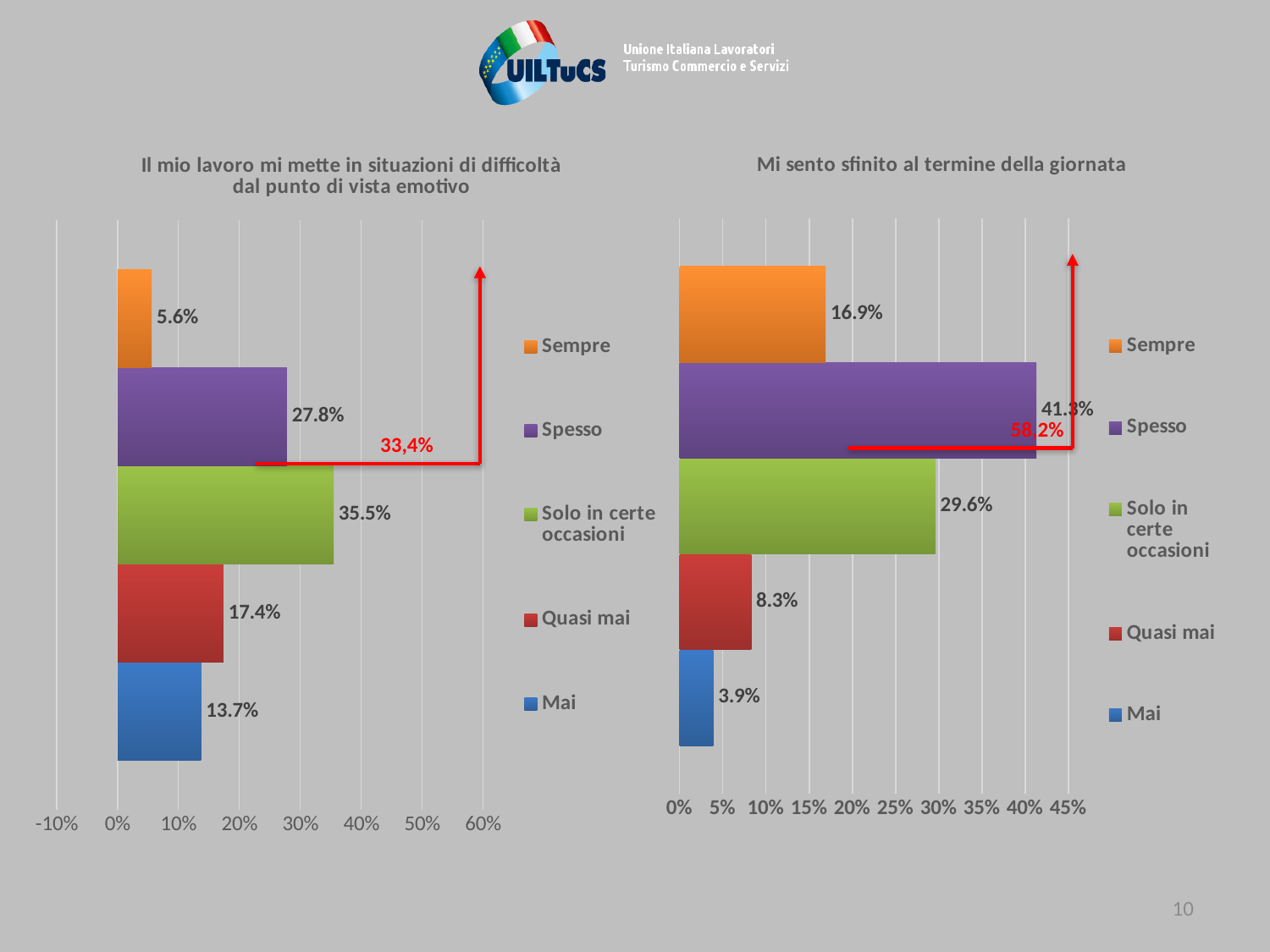
In the chart titled 'Mi sento sfinito al termine della giornata', which category has the highest value? Spesso In the chart titled 'Mi sento sfinito al termine della giornata', what is the value for 'Mai'? 3.9% In the chart titled 'Il mio lavoro mi mette in situazioni di difficoltà dal punto di vista emotivo', what is the value for 'Solo in certe occasioni'? 35.5% What kind of chart is the chart titled 'Il mio lavoro mi mette in situazioni di difficoltà dal punto di vista emotivo'? Bar chart In the chart titled 'Mi sento sfinito al termine della giornata', what is the difference between 'Spesso' and 'Solo in certe occasioni'? 11.7% How many categories does the chart titled 'Mi sento sfinito al termine della giornata' show? 5 In the chart titled 'Mi sento sfinito al termine della giornata', is the value for 'Sempre' greater or less than 20%? less In the chart titled 'Il mio lavoro mi mette in situazioni di difficoltà dal punto di vista emotivo', which category has the lowest value? Sempre In the chart titled 'Mi sento sfinito al termine della giornata', what is the value for 'Spesso'? 41.3% In the chart titled 'Mi sento sfinito al termine della giornata', what red annotation value is shown next to the arrow? 58,2% In the chart titled 'Il mio lavoro mi mette in situazioni di difficoltà dal punto di vista emotivo', which is larger, 'Spesso' or 'Quasi mai'? Spesso In the chart titled 'Il mio lavoro mi mette in situazioni di difficoltà dal punto di vista emotivo', what is the difference between 'Quasi mai' and 'Mai'? 3.7%